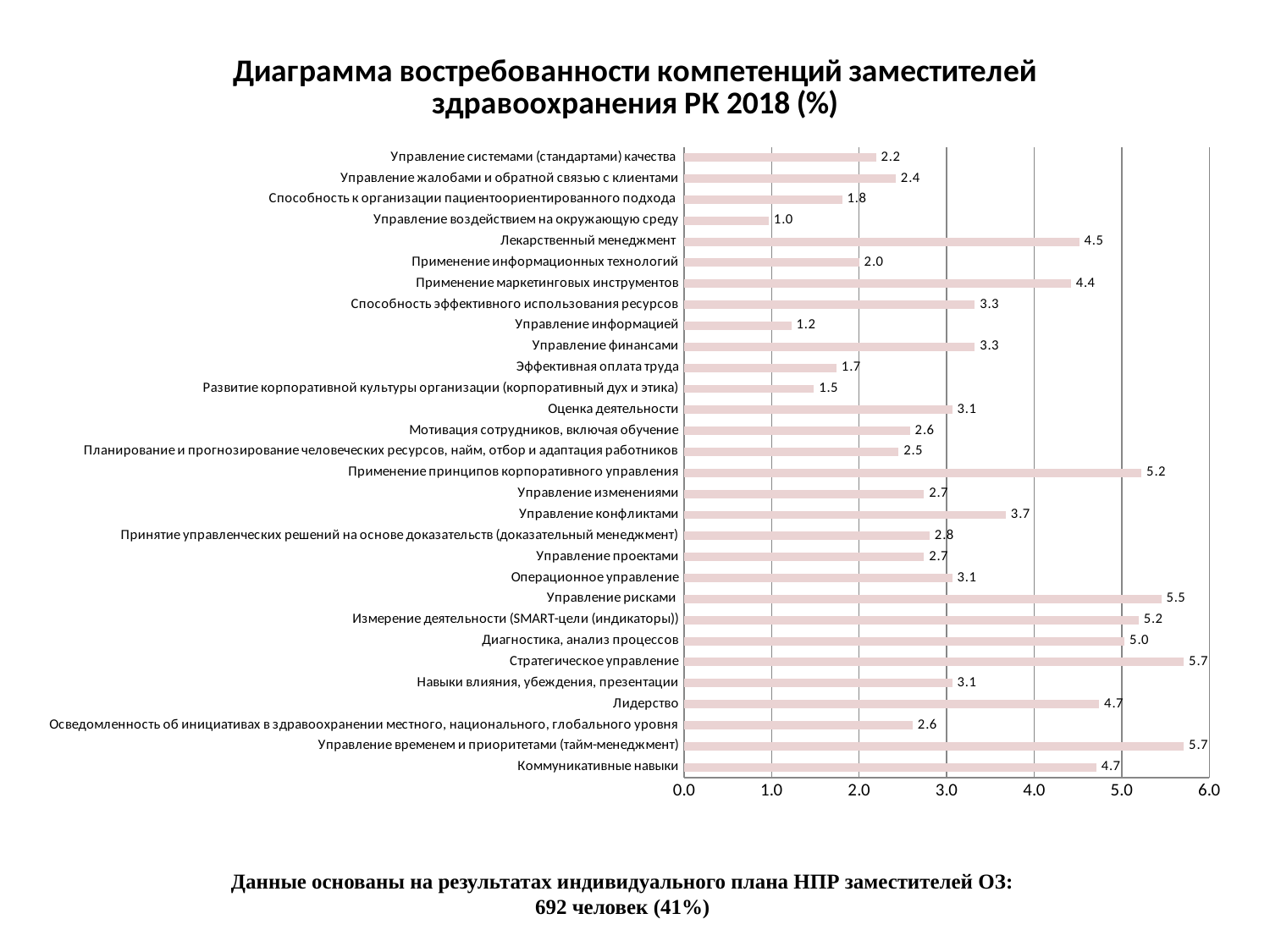
Which is larger, the value for Оценка деятельности or the value for Мотивация сотрудников, включая обучение? Оценка деятельности What is the value for Лекарственный менеджмент? 4.5 Which is larger, the value for Применение маркетинговых инструментов or the value for Применение информационных технологий? Применение маркетинговых инструментов What is the value for Управление рисками? 5.5 How many categories are shown in the chart? 30 What is the difference between the values for Управление рисками and Управление информацией? 4.3 What is the value for Управление конфликтами? 3.7 What is the title of the chart? Диаграмма востребованности компетенций заместителей здравоохранения РК 2018 (%) What is the difference between the values for Стратегическое управление and Диагностика, анализ процессов? 0.7 What is the value for Лидерство? 4.7 Which category has the lowest value? Управление воздействием на окружающую среду What type of chart is shown on the slide? bar chart